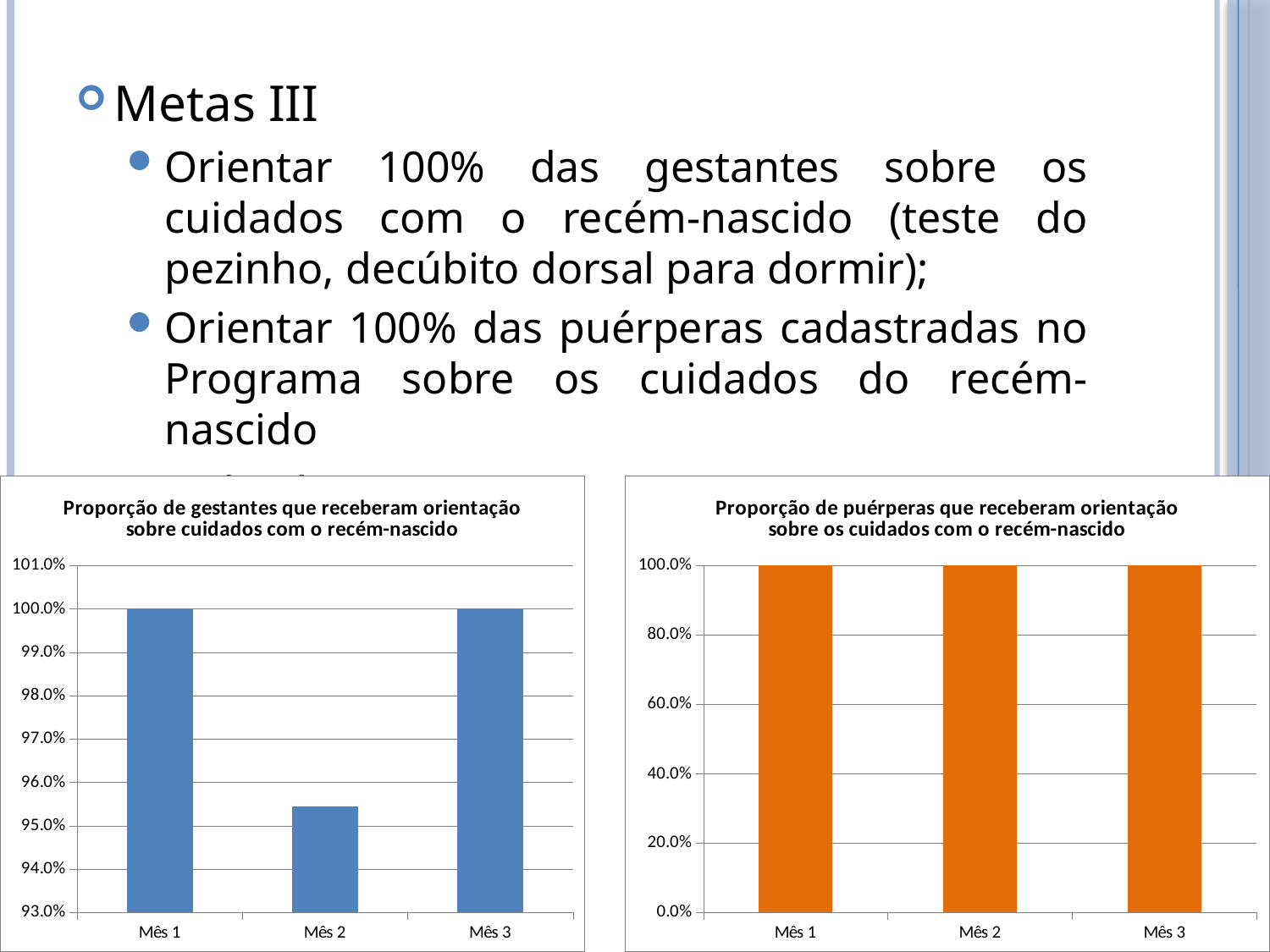
In the chart titled 'Proporção de gestantes que receberam orientação sobre cuidados com o recém-nascido', is the value for Mês 2 greater or less than 95.0%? greater In the chart titled 'Proporção de gestantes que receberam orientação sobre cuidados com o recém-nascido', what is the value for Mês 3? 100.0% In the chart titled 'Proporção de puérperas que receberam orientação sobre os cuidados com o recém-nascido', what is the value for Mês 2? 100.0% What is the title of the chart on the right of the slide? Proporção de puérperas que receberam orientação sobre os cuidados com o recém-nascido What kind of chart is the chart on the right of the slide? bar chart In the chart titled 'Proporção de puérperas que receberam orientação sobre os cuidados com o recém-nascido', do the values rise, fall or stay the same from Mês 1 to Mês 3? stay the same In the chart titled 'Proporção de gestantes que receberam orientação sobre cuidados com o recém-nascido', which month has the lowest value? Mês 2 In the chart titled 'Proporção de gestantes que receberam orientação sobre cuidados com o recém-nascido', what is the value for Mês 1? 100.0% How many months are shown on the x axis of the chart titled 'Proporção de puérperas que receberam orientação sobre os cuidados com o recém-nascido'? 3 In the chart titled 'Proporção de gestantes que receberam orientação sobre cuidados com o recém-nascido', is the value for Mês 2 greater or less than 96.0%? less In the chart titled 'Proporção de gestantes que receberam orientação sobre cuidados com o recém-nascido', which is larger, the value for Mês 1 or Mês 2? Mês 1 What colour are the bars in the chart titled 'Proporção de gestantes que receberam orientação sobre cuidados com o recém-nascido'? blue